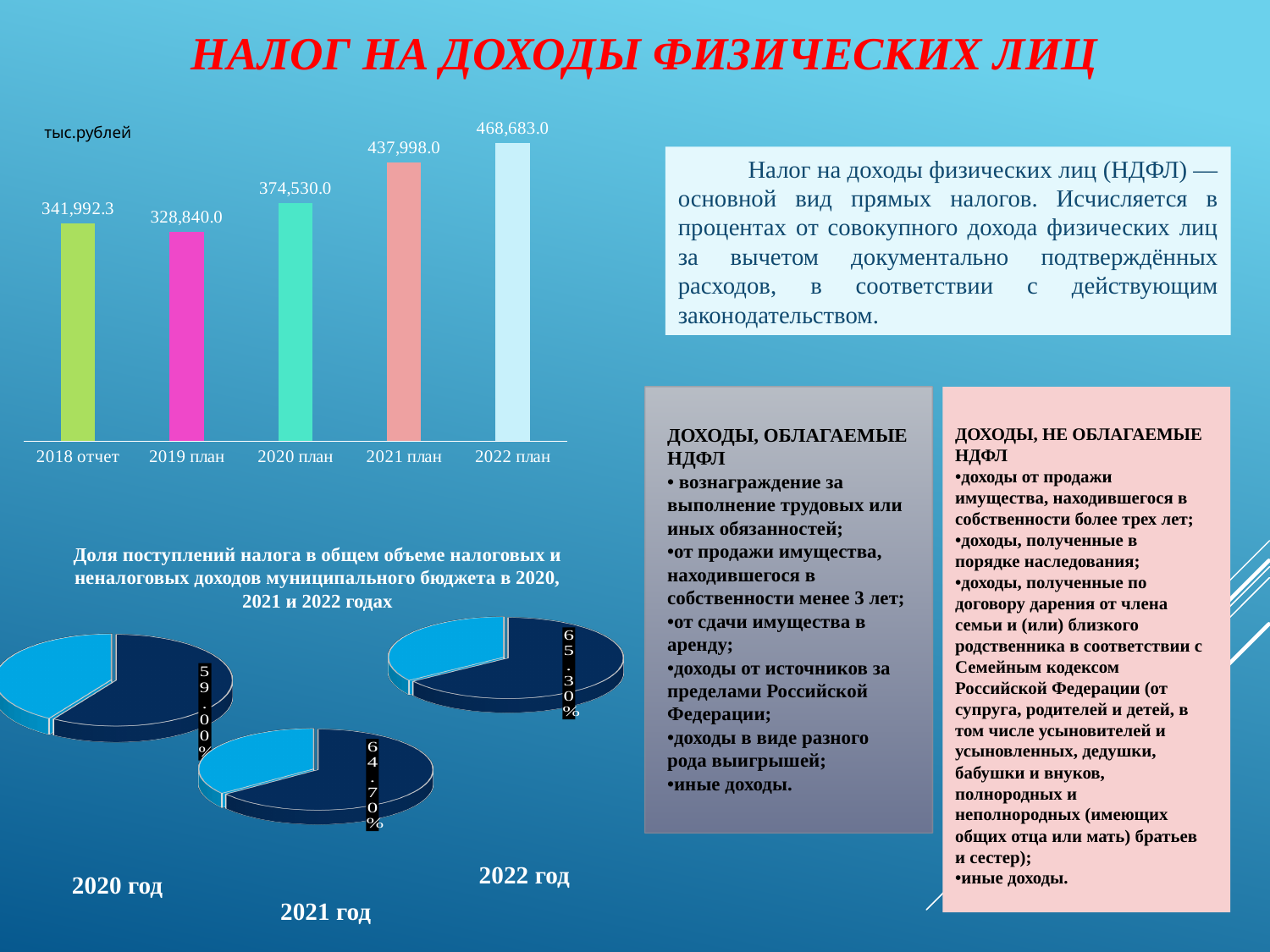
In the pie chart for 2020 год, what share is labelled on the dark slice? 59.00% In the bar chart, which category has the highest value? 2022 план How many categories are shown in the bar chart? 5 In the bar chart, what is the difference between the values for 2022 план and 2021 план? 30,685.0 In the bar chart, which category has the lowest value? 2019 план What unit is shown for the bar chart values? тыс.рублей In the bar chart, which is larger: the value for 2020 план or the value for 2019 план? 2020 план In the pie chart for 2022 год, what share is labelled on the dark slice? 65.30% In the bar chart, do the values rise or fall from 2019 план to 2022 план? rise What kind of chart is the chart at the top left of the slide? bar chart In the bar chart, what is the value for 2018 отчет? 341,992.3 In the bar chart, what is the value for 2021 план? 437,998.0